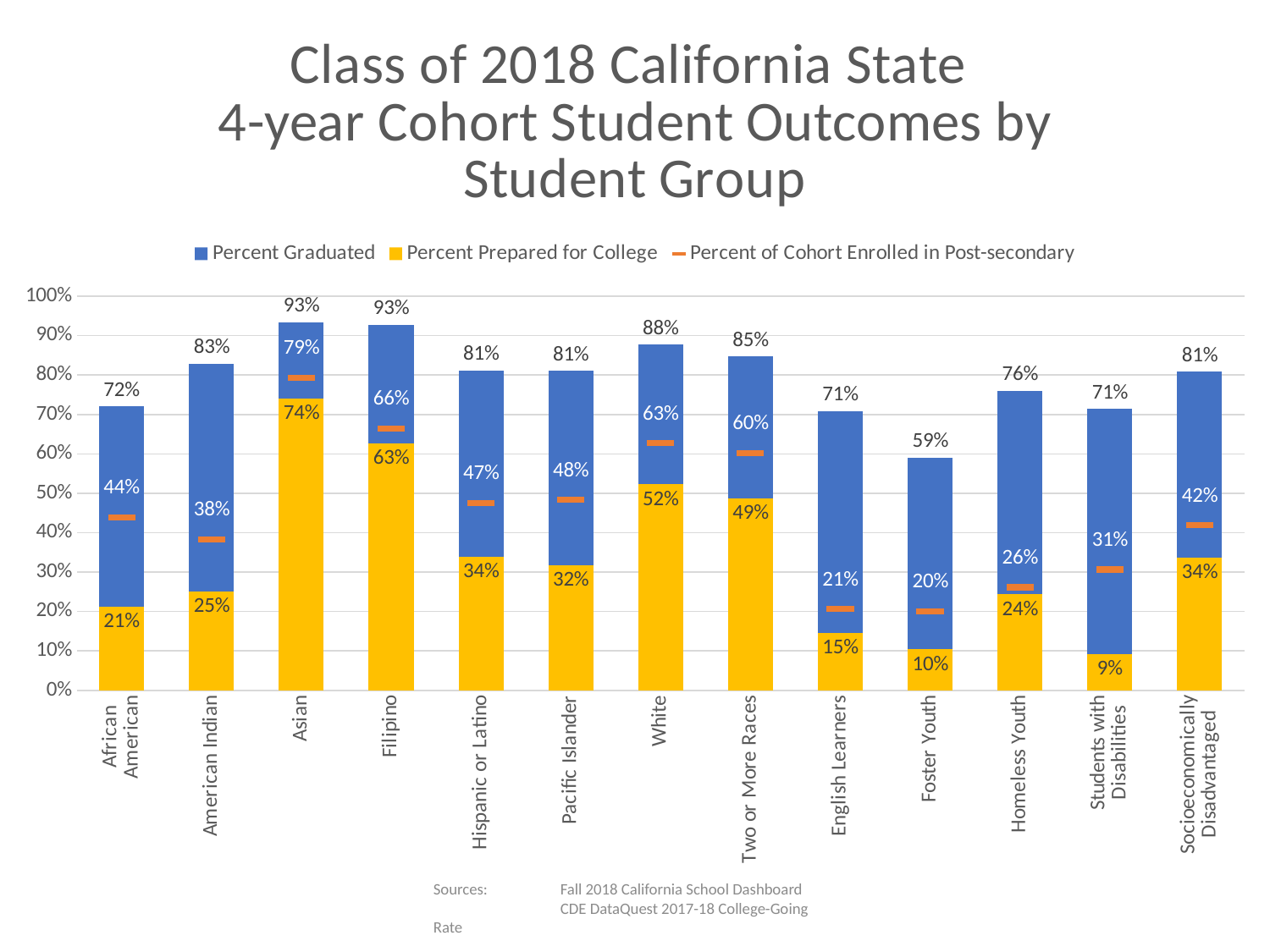
What is the Percent Graduated for Asian students? 93% What is the difference between the Percent Graduated for Filipino students and for English Learners? 22% Which student group has the lowest Percent Graduated? Foster Youth What kind of chart is shown on the slide? Bar chart Which colour represents Percent Prepared for College in the legend? Yellow How many student groups are shown on the x axis? 13 Which is larger, the Percent Prepared for College for White students or for Two or More Races? White What is the Percent Prepared for College for Hispanic or Latino students? 34% What is the Percent of Cohort Enrolled in Post-secondary for White students? 63% How many series does the legend list? 3 Which student group has the highest Percent Prepared for College? Asian What is the Percent Prepared for College for Students with Disabilities? 9%